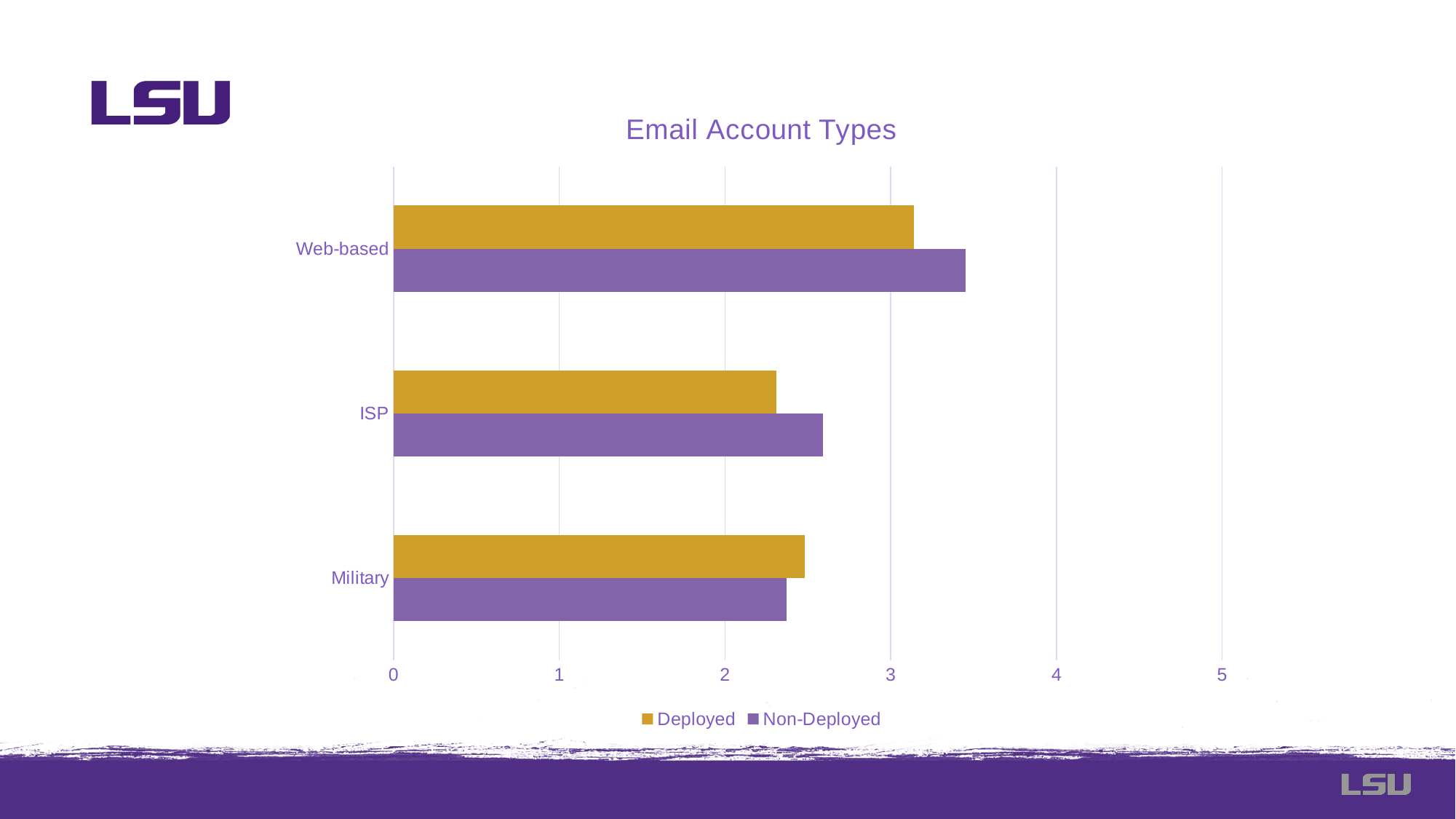
Which category has the lowest Non-Deployed value? Military How many series does the legend list? 2 Which category has the highest Deployed value? Web-based What is the title of the chart? Email Account Types How many email account type categories are shown on the chart? 3 For Military, which is larger: Deployed or Non-Deployed? Deployed For Web-based, which is larger: Deployed or Non-Deployed? Non-Deployed Is the Non-Deployed value for Military greater or less than 2? greater Is the Non-Deployed value for Web-based greater or less than 3? greater What kind of chart is shown on the slide? Bar chart Which category has the highest Non-Deployed value? Web-based Is the Deployed value for ISP greater or less than 3? less